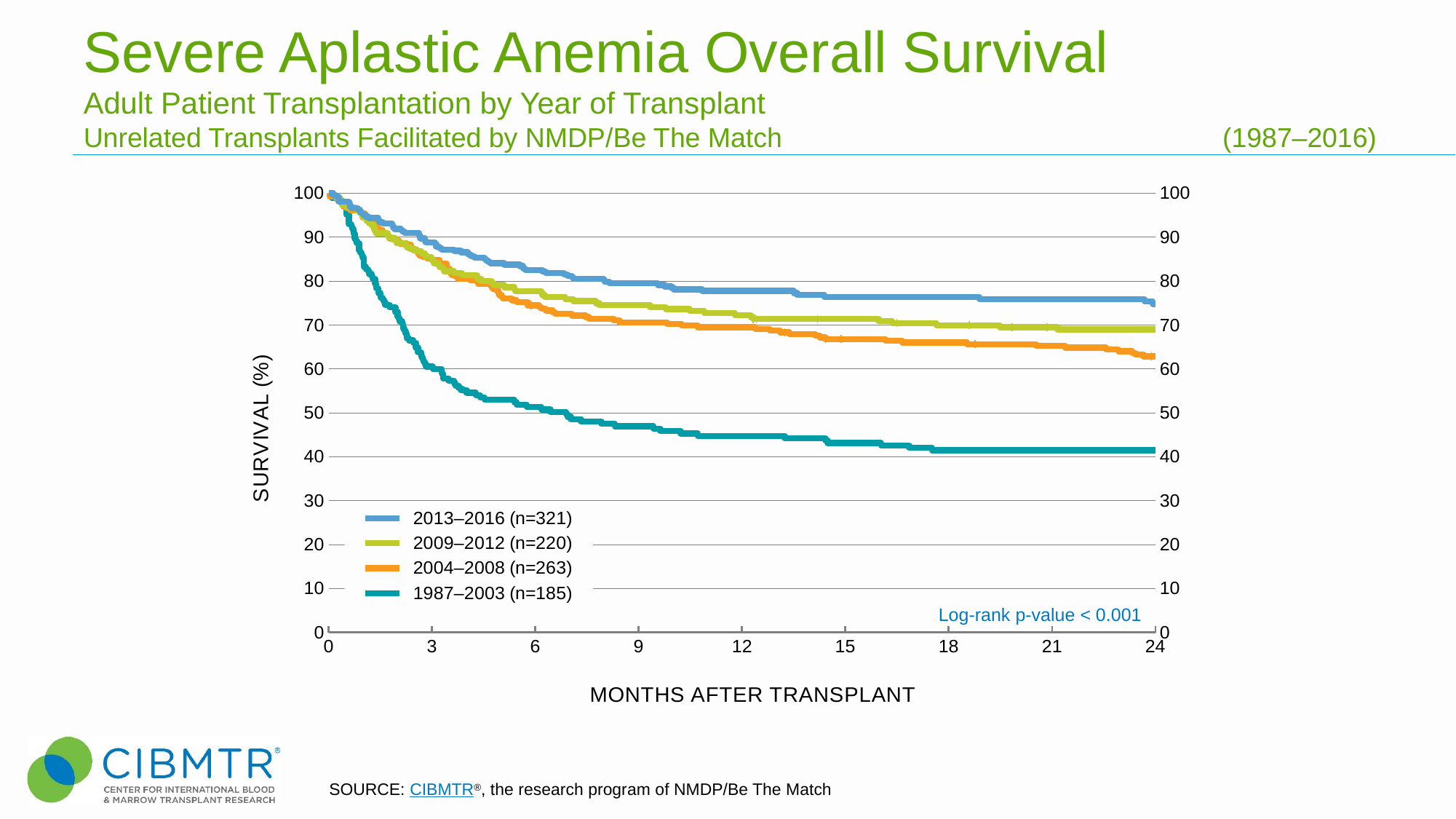
What log-rank p-value is shown on the chart? < 0.001 How many series does the legend list? 4 How many patients (n) are in the 1987–2003 group according to the legend? 185 Is the survival for the 2013–2016 group at 24 months greater or less than 70? greater Is the survival for the 2004–2008 group at 24 months greater or less than 70? less Is the survival for the 1987–2003 group at 24 months greater or less than 50? less Which transplant-year group has the lowest survival at 24 months after transplant? 1987–2003 Do the survival curves rise or fall as months after transplant increase? fall Which transplant-year group has the highest survival at 24 months after transplant? 2013–2016 What kind of chart is shown on the slide? line chart How many patients (n) are in the 2013–2016 group according to the legend? 321 At 12 months after transplant, which group has higher survival: 2009–2012 or 2004–2008? 2009–2012